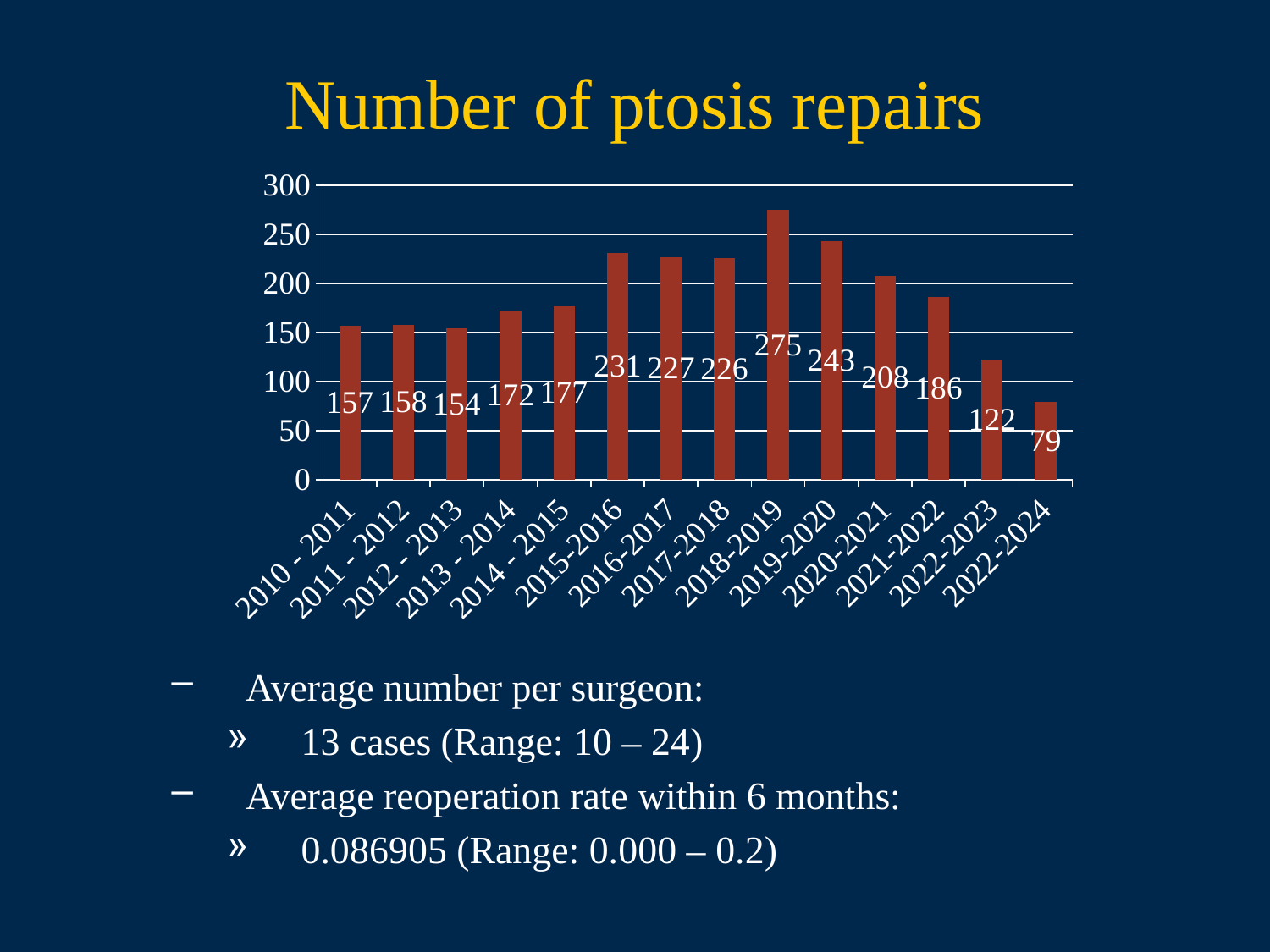
What kind of chart is shown on the slide? bar chart How many periods (bars) are shown on the chart? 14 Do the values rise or fall from 2018-2019 to 2022-2024? fall What is the difference between the values for 2022-2023 and 2022-2024? 43 How many ptosis repairs were there in 2018-2019? 275 What is the value for 2022-2024? 79 Which period has the highest number of ptosis repairs? 2018-2019 What is the title of the chart? Number of ptosis repairs Which is larger, the value for 2015-2016 or the value for 2020-2021? 2015-2016 Which period has the lowest number of ptosis repairs? 2022-2024 What is the difference between the values for 2018-2019 and 2019-2020? 32 What is the value for 2012 - 2013? 154